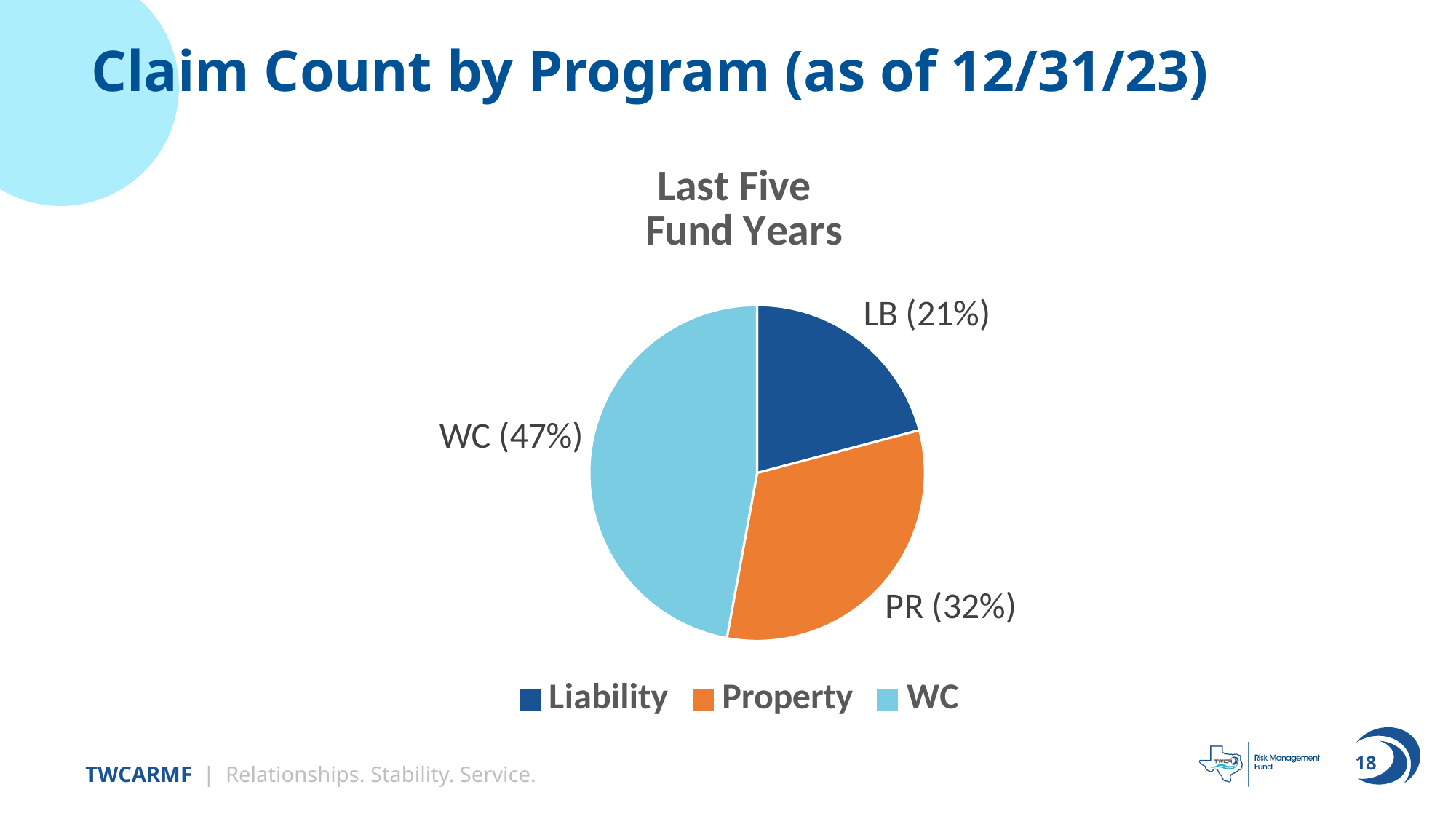
Which program has the smallest share of claims? LB (Liability) What is the difference in percentage points between the WC share and the PR share? 15 How many slices does the pie chart have? 3 What share of the pie does WC account for? 47% Which program has the largest share of claims? WC What share of the pie does PR (Property) account for? 32% What share of the pie does LB (Liability) account for? 21% How many entries does the legend list? 3 What kind of chart is shown on the slide? Pie chart What is the difference in percentage points between the PR share and the LB share? 11 What is the title shown above the pie chart? Last Five Fund Years Which has a larger share, Property or Liability? Property